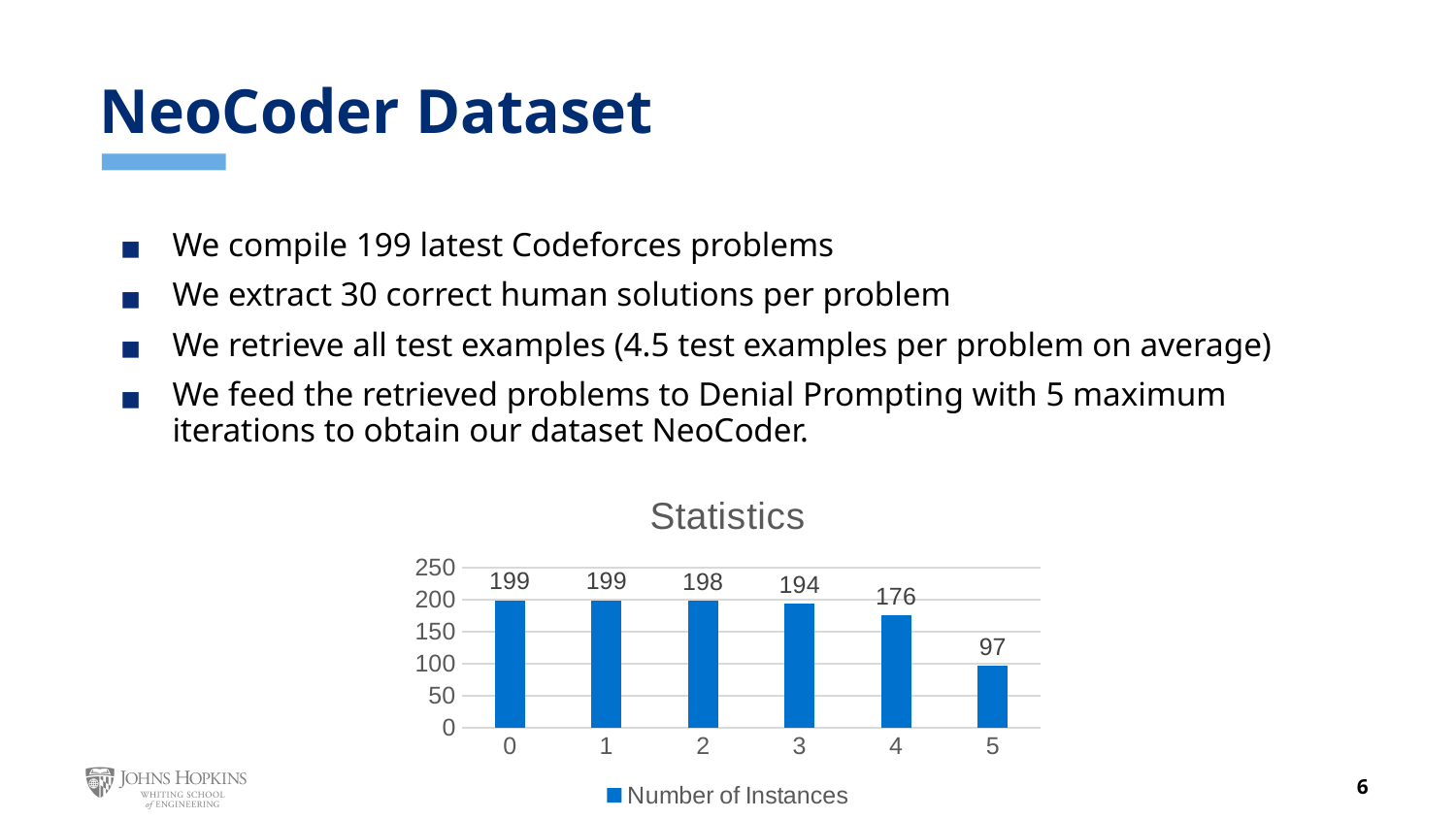
What is the value for category 3 in the Statistics chart? 194 Which category has the lowest value in the Statistics chart? 5 Is the value for category 5 greater or less than 150? less How many series does the legend of the Statistics chart list? 1 Do the values rise or fall from category 0 to category 5? fall Which is larger, the value for category 2 or the value for category 4? category 2 What is the difference between the values for category 0 and category 3? 5 What is the value for category 5 in the Statistics chart? 97 What is the value for category 4 in the Statistics chart? 176 How many categories are shown on the x axis of the Statistics chart? 6 What kind of chart is shown on the slide? bar chart What is the difference between the values for category 4 and category 5? 79